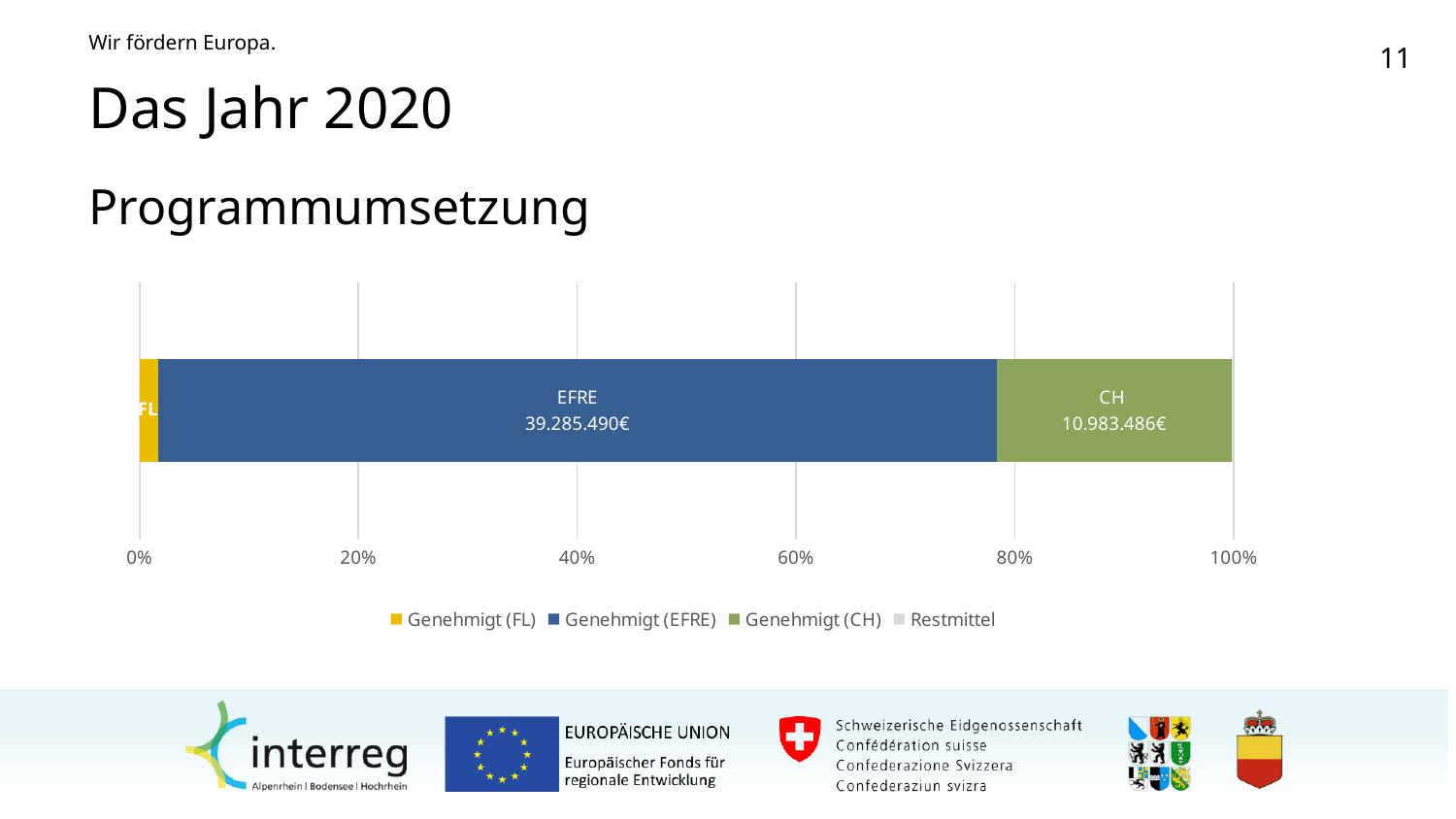
Which labelled segment of the bar has the largest value, EFRE or CH? EFRE Is the share of the bar taken by the EFRE segment greater or less than 60%? greater What kind of chart is shown on the slide? Stacked bar chart What value is shown for the EFRE segment of the bar? 39.285.490€ What value is shown for the CH segment of the bar? 10.983.486€ What is the difference between the EFRE value and the CH value? 28.302.004€ Is the share of the bar taken by the CH segment greater or less than 40%? less What is the highest value shown on the horizontal axis? 100% How many series does the legend list? 4 What colour is the Genehmigt (EFRE) segment in the chart? Blue Is the share of the bar taken by the FL segment greater or less than 20%? less Which segment takes up the largest share of the bar? EFRE